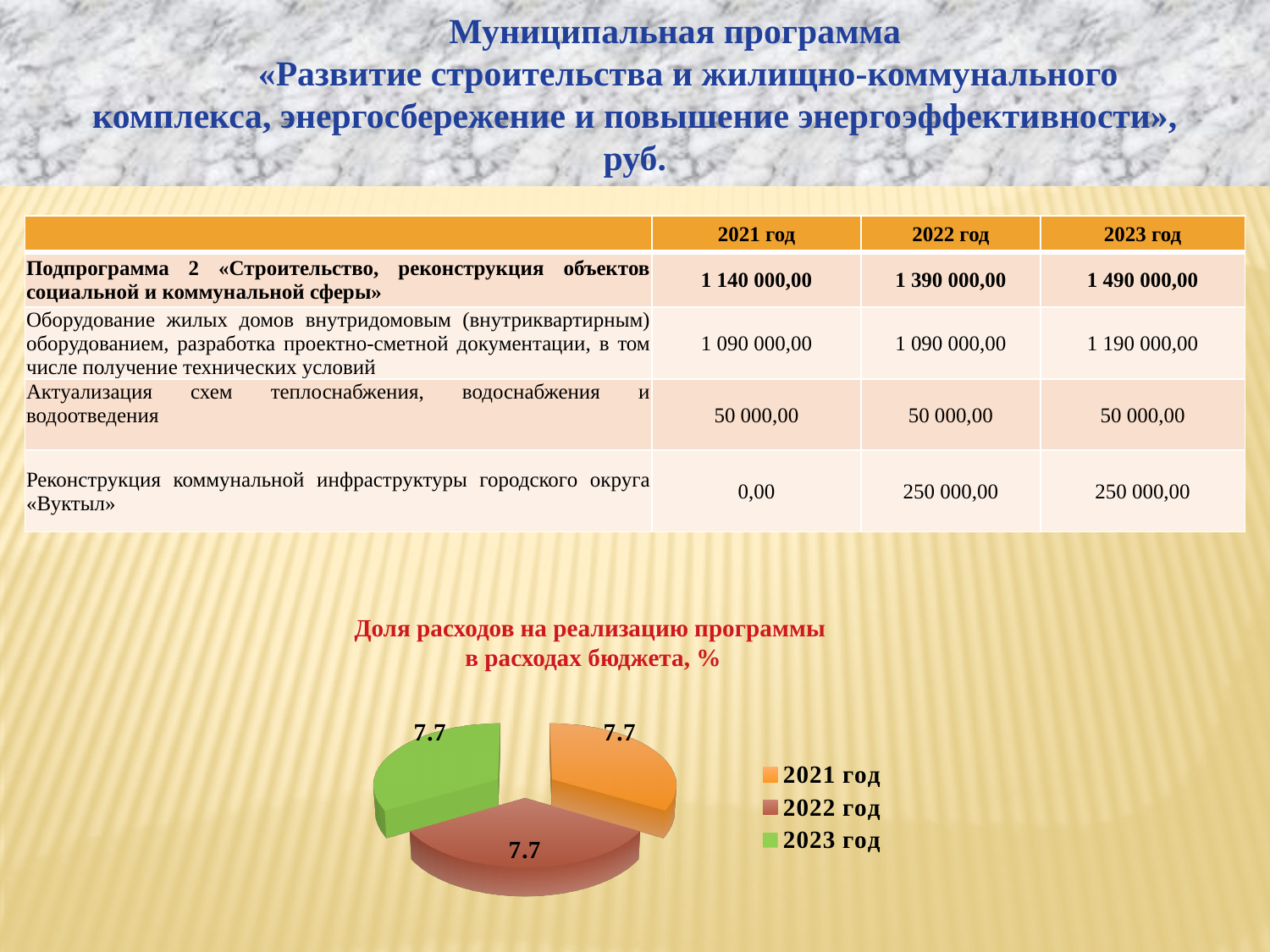
How many slices does the pie chart have? 3 What kind of chart is shown on the slide? pie chart How many entries does the legend of the pie chart list? 3 What is the title of the pie chart? Доля расходов на реализацию программы в расходах бюджета, % What is the value shown for 2021 год in the pie chart? 7.7 What is the value shown for 2023 год in the pie chart? 7.7 Is the value for 2022 год in the pie chart greater or less than 10? less What is the value shown for 2022 год in the pie chart? 7.7 What is the difference between the values for 2022 год and 2021 год in the pie chart? 0.0 What is the difference between the values for 2021 год and 2023 год in the pie chart? 0.0 Which colour represents 2023 год in the pie chart? green